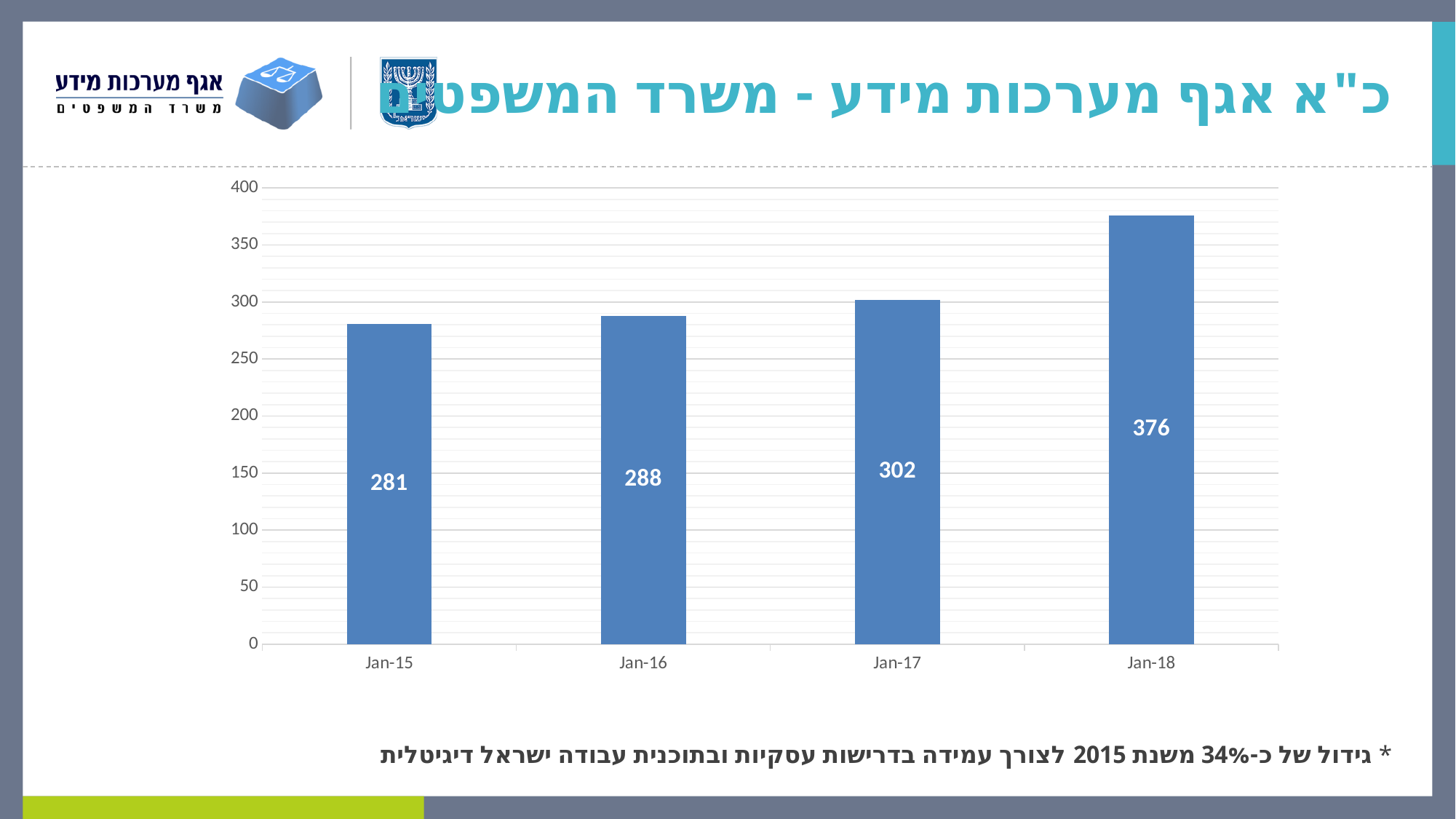
What is the value for Jan-15? 281 Which is larger, the value for Jan-16 or the value for Jan-17? Jan-17 Which category has the highest value? Jan-18 Is the value for Jan-18 greater or less than 350? greater What is the value for Jan-16? 288 What is the value for Jan-17? 302 What kind of chart is shown on the slide? bar chart What is the value for Jan-18? 376 How many categories are shown on the x axis? 4 What is the difference between the values for Jan-18 and Jan-15? 95 What is the difference between the values for Jan-17 and Jan-16? 14 Which category has the lowest value? Jan-15